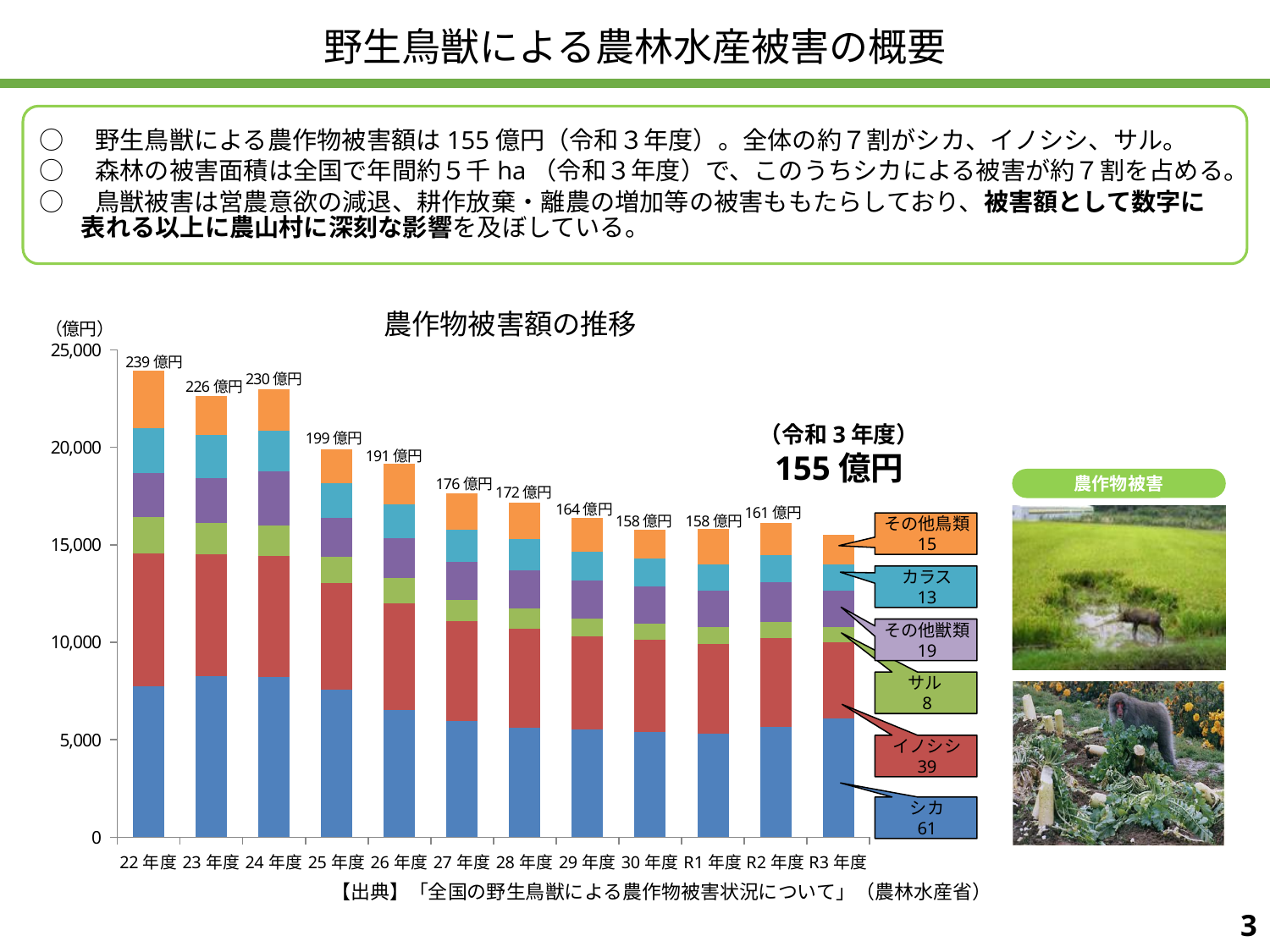
In the chart 農作物被害額の推移, how many animal categories are labeled for the R3年度 bar? 6 How many fiscal years are shown on the x axis of the chart 農作物被害額の推移? 12 In the chart 農作物被害額の推移, what is the value labeled for イノシシ in R3年度? 39 In the chart 農作物被害額の推移, which is larger, the total for 23年度 or the total for 24年度? 24年度 In the chart 農作物被害額の推移, what is the total labeled for R3年度? 155億円 In the chart 農作物被害額の推移, what is the value labeled for シカ in R3年度? 61 In the chart 農作物被害額の推移, what is the total crop damage amount labeled for 22年度? 239億円 In the chart 農作物被害額の推移, what is the difference between the totals for 22年度 and R3年度? 84億円 In the chart 農作物被害額の推移, do the total crop damage amounts generally rise or fall from 22年度 to R3年度? fall In the chart 農作物被害額の推移, which fiscal year has the highest total crop damage amount? 22年度 In the chart 農作物被害額の推移, which fiscal year has the lowest total crop damage amount? R3年度 What type of chart is 農作物被害額の推移? stacked bar chart